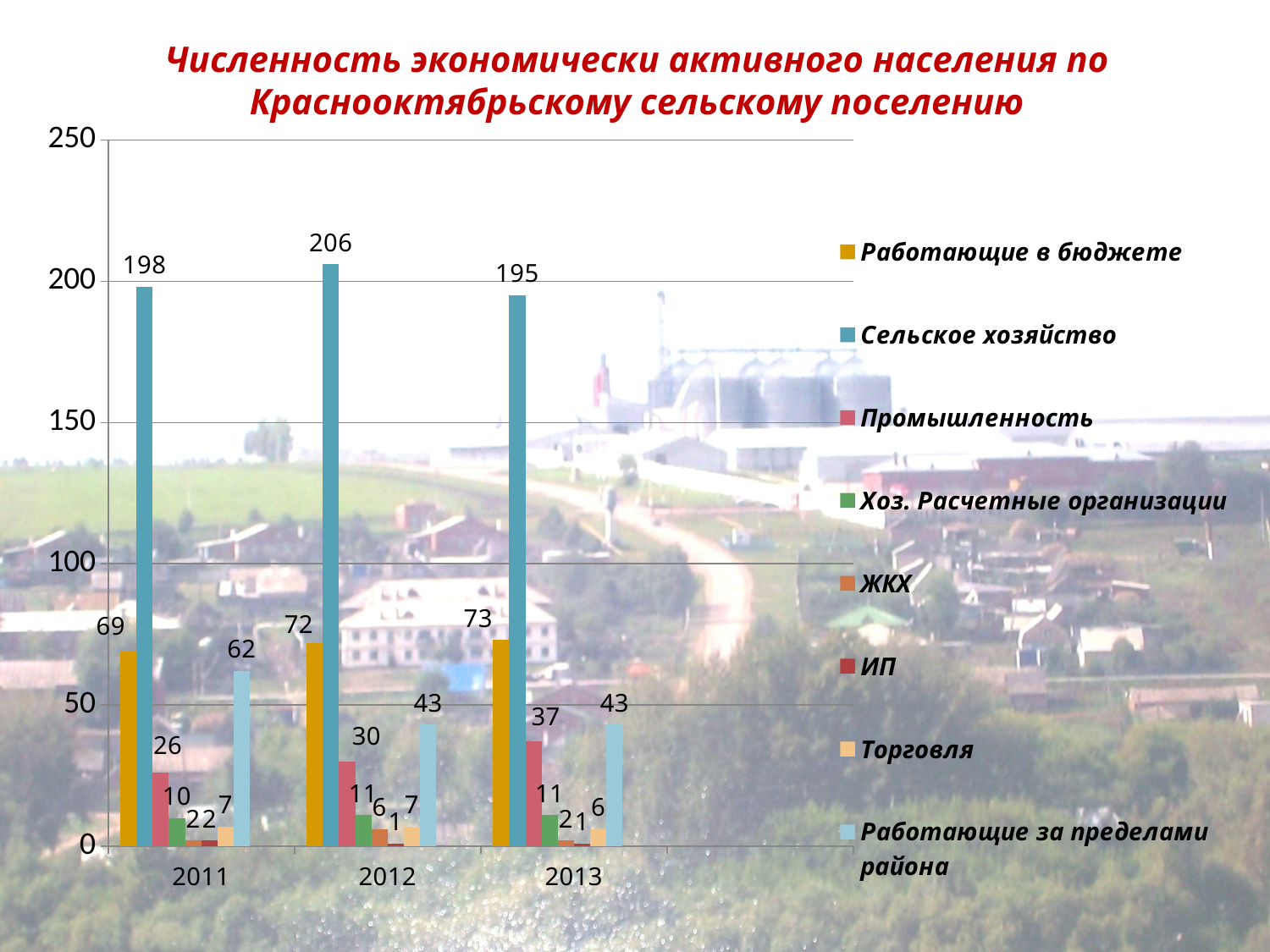
What is the value for Промышленность in 2013? 37 What is the value for Работающие за пределами района in 2011? 62 In which year is the value for Сельское хозяйство highest? 2012 What kind of chart is shown on the slide? Bar chart In which year is the value for Работающие за пределами района lowest? 2012 and 2013 (both 43) Do the values for Промышленность rise or fall from 2011 to 2013? Rise What is the value for Работающие в бюджете in 2012? 72 Which is larger: Промышленность in 2011 or Промышленность in 2012? 2012 What is the value for Сельское хозяйство in 2012? 206 How many years are shown on the x axis? 3 How many series does the legend list? 8 What is the difference between the Сельское хозяйство values for 2012 and 2013? 11